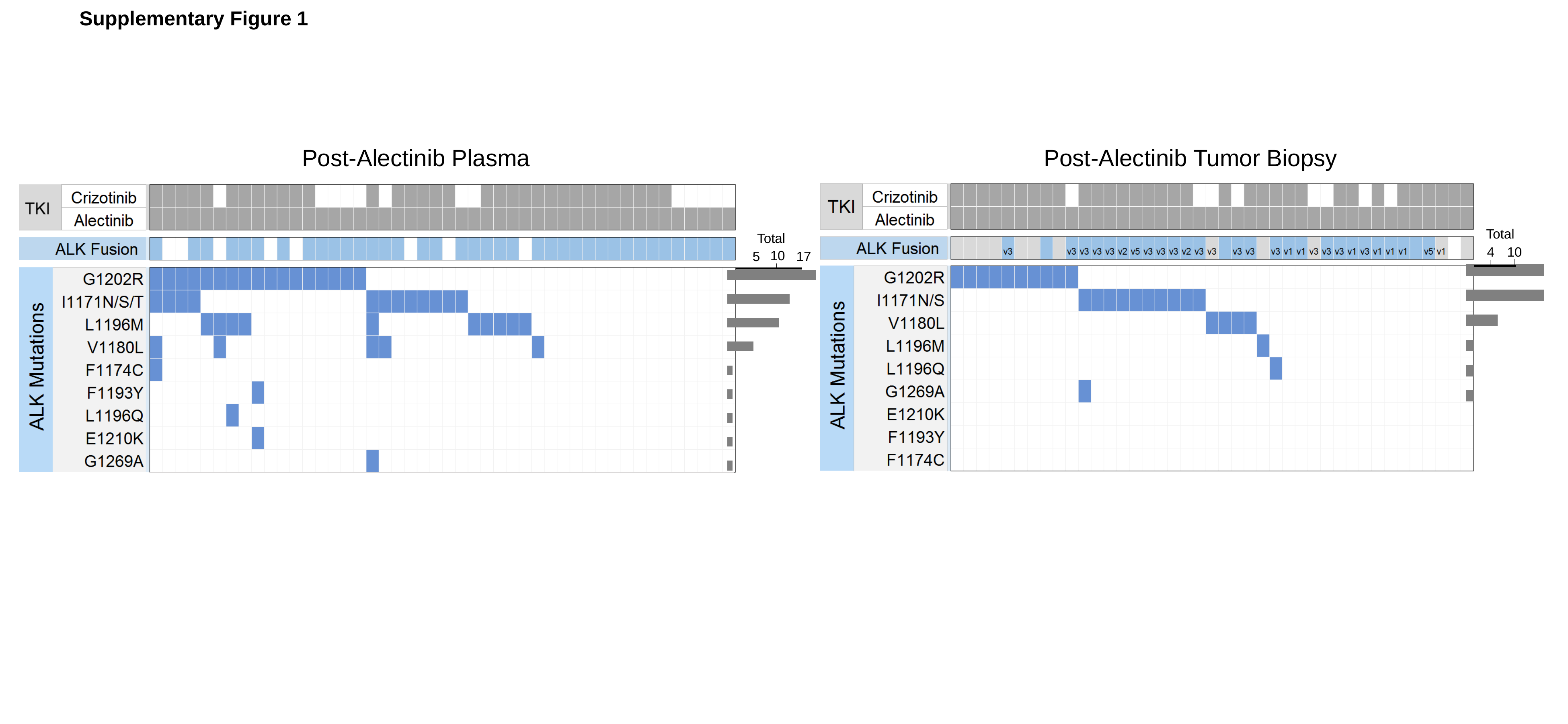
In the Post-Alectinib Tumor Biopsy chart, is the Total for L1196M greater or less than 4? less In the Post-Alectinib Plasma chart, which ALK mutation has the highest Total? G1202R In the Post-Alectinib Plasma chart, is the Total for V1180L greater or less than 10? less Which two TKIs are shown in the TKI rows of the charts? Crizotinib and Alectinib In the Post-Alectinib Tumor Biopsy chart, is the Total for G1202R greater or less than 4? greater In the Post-Alectinib Plasma chart, which has a larger Total, I1171N/S/T or L1196M? I1171N/S/T What is the title of the left chart? Post-Alectinib Plasma In the Post-Alectinib Plasma chart, how many ALK mutations are listed as rows? 9 In the Post-Alectinib Tumor Biopsy chart, which has a larger Total, V1180L or L1196Q? V1180L In the Post-Alectinib Plasma chart, what is the Total for G1202R? 17 In the Post-Alectinib Tumor Biopsy chart, how many ALK mutations are listed as rows? 9